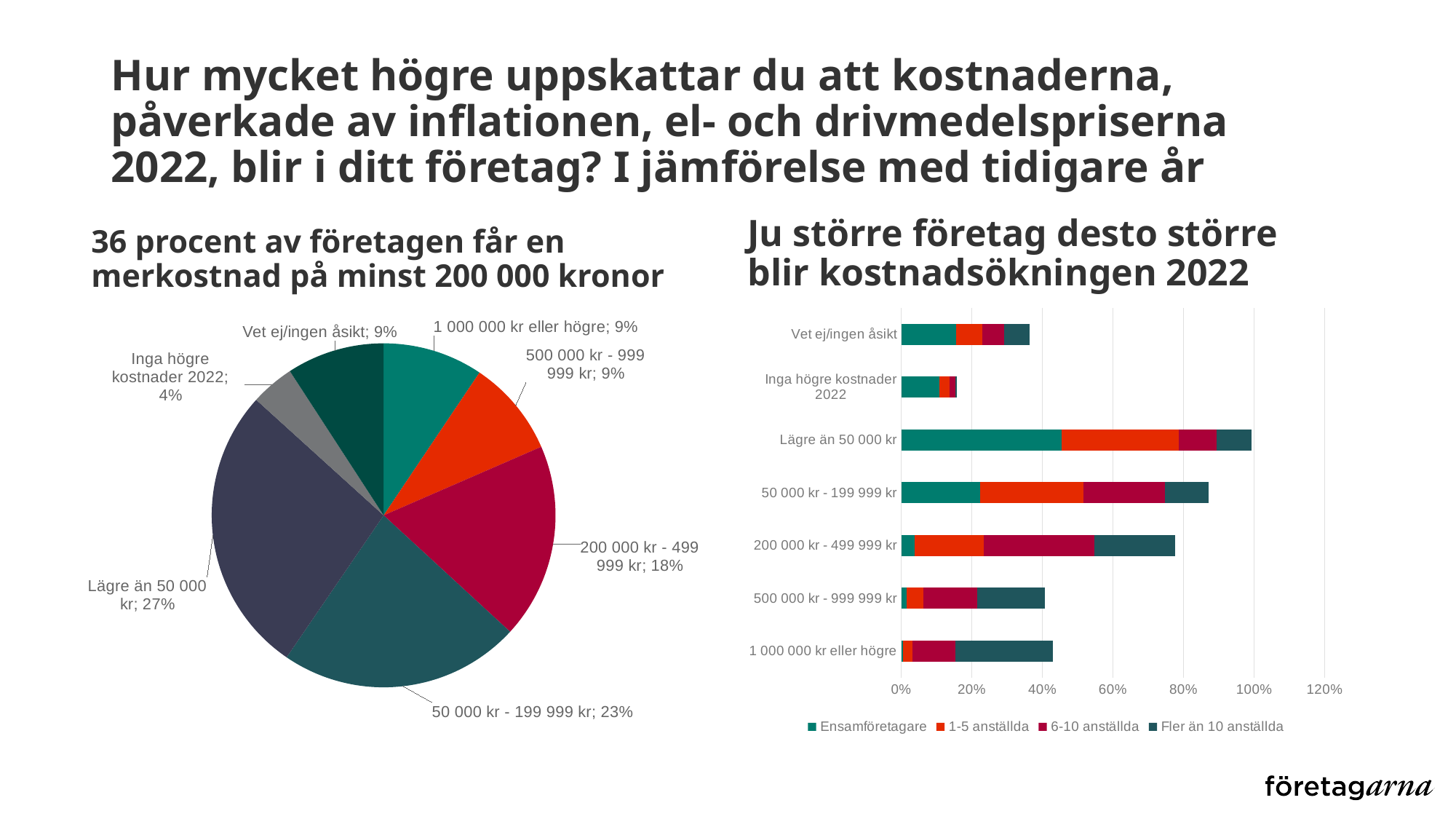
How many slices does the pie chart on the left have? 7 What is the title of the chart on the right of the slide? Ju större företag desto större blir kostnadsökningen 2022 How many series does the legend of the bar chart on the right list? 4 In the pie chart on the left, what share of companies answered 'Lägre än 50 000 kr'? 27% What kind of chart is the chart on the right of the slide? Bar chart In the pie chart on the left, what share of companies answered '200 000 kr - 499 999 kr'? 18% In the pie chart on the left, which is larger: '50 000 kr - 199 999 kr' or '500 000 kr - 999 999 kr'? 50 000 kr - 199 999 kr In the bar chart on the right, is the total value for 'Lägre än 50 000 kr' greater or less than 80%? greater In the bar chart on the right, is the total value for 'Inga högre kostnader 2022' greater or less than 20%? less In the pie chart on the left, which category has the smallest share? Inga högre kostnader 2022 In the pie chart on the left, what is the difference in percentage points between '50 000 kr - 199 999 kr' and '200 000 kr - 499 999 kr'? 5 In the pie chart on the left, which category has the largest share? Lägre än 50 000 kr